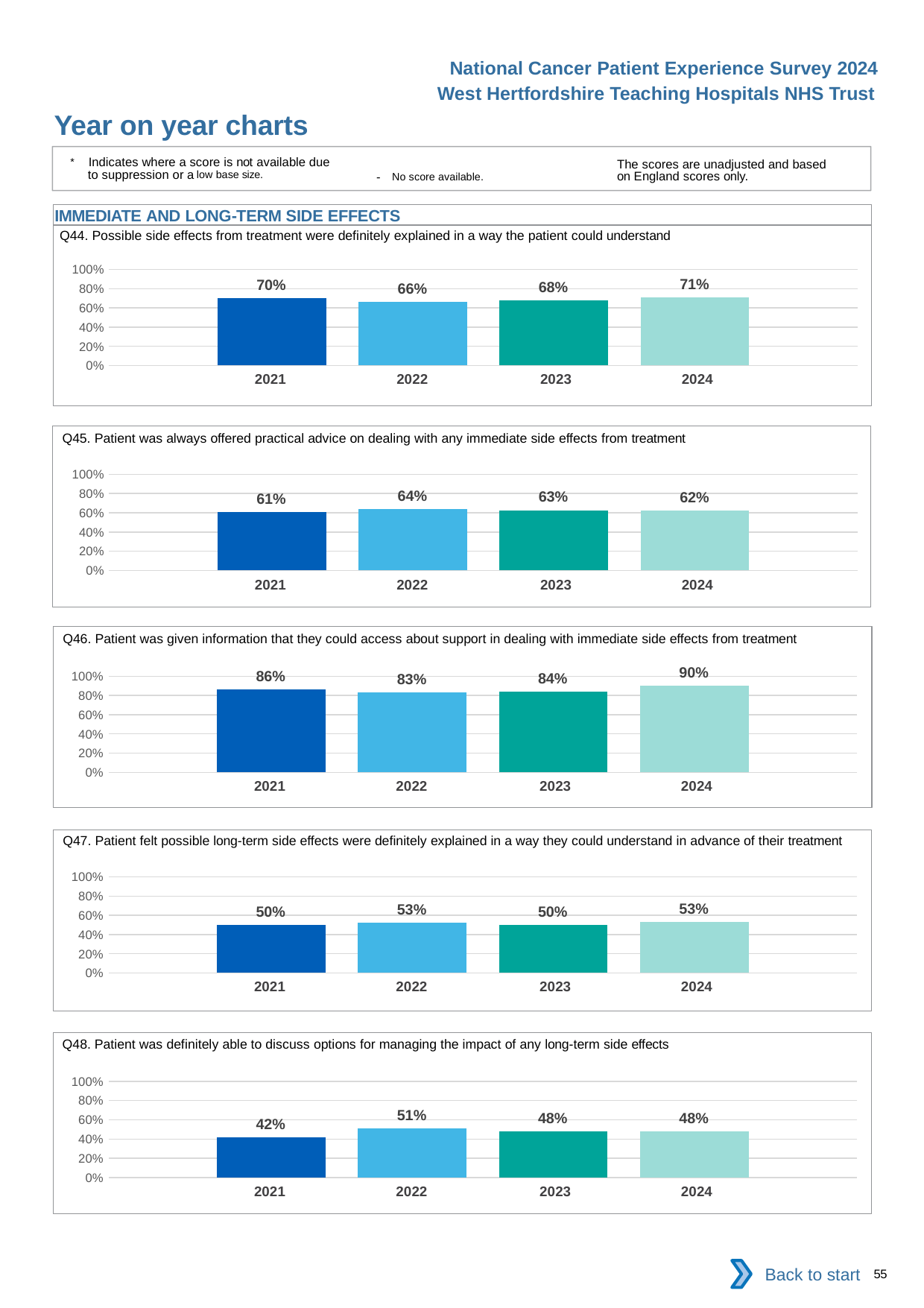
How many charts are shown on the slide? 5 In the Q45 chart, which year has the highest value? 2022 In the Q46 chart, is the value for 2024 greater or less than 80%? greater What kind of chart is the Q47 chart? bar chart In the Q44 chart, what is the value for 2024? 71% In the Q48 chart, what is the difference between the 2022 and 2021 values? 9% In the Q46 chart, what is the value for 2021? 86% How many years are shown in the Q45 chart? 4 In the Q46 chart, what is the difference between the 2024 and 2022 values? 7% In the Q44 chart, which is larger, the value for 2021 or the value for 2022? 2021 In the Q47 chart, what is the value for 2021? 50% In the Q48 chart, which year has the lowest value? 2021